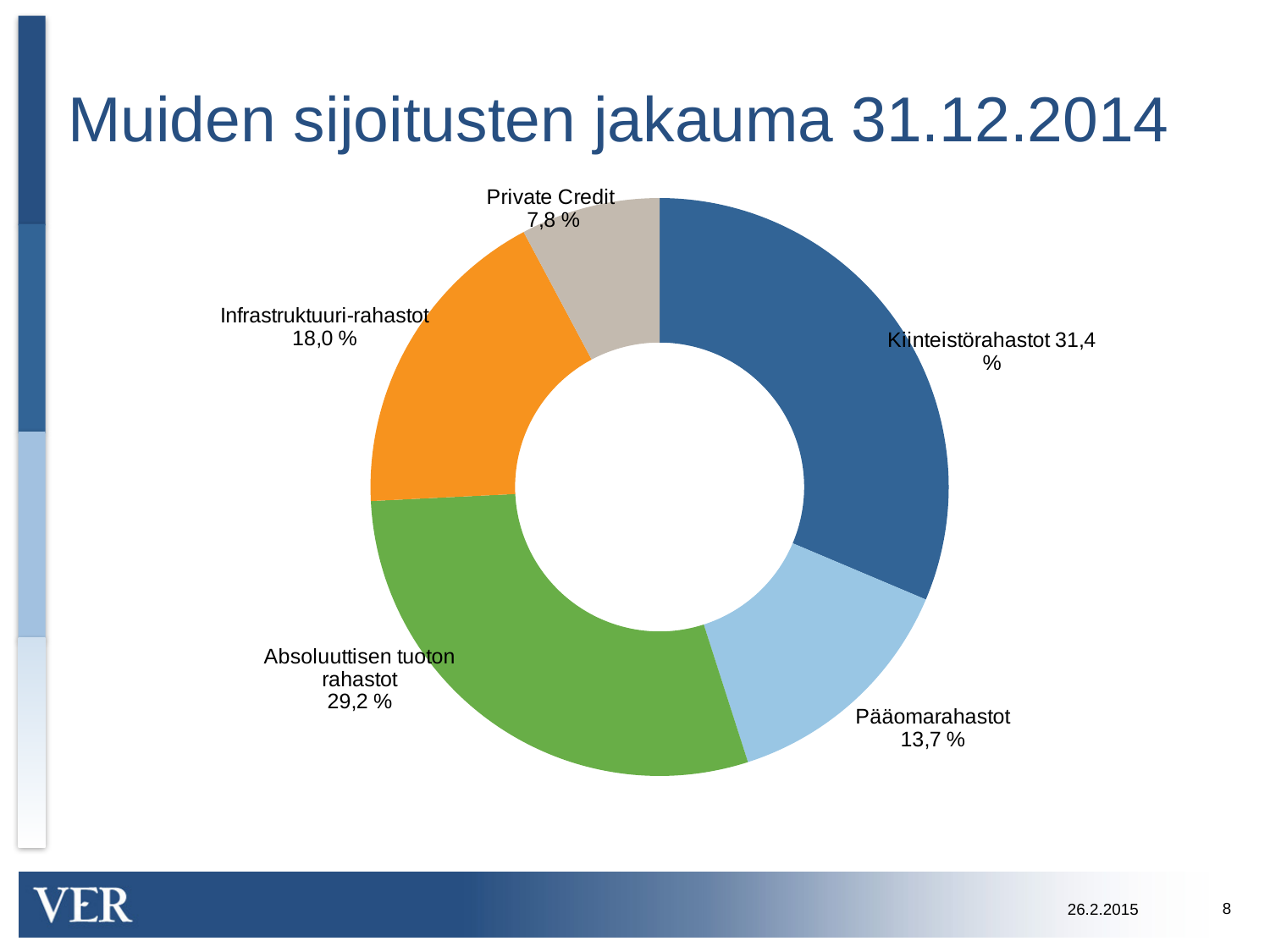
What share does Kiinteistörahastot have in the chart? 31,4 % How many categories are shown in the chart? 5 Which category has the smallest share? Private Credit Which is larger, the share of Absoluuttisen tuoton rahastot or Infrastruktuuri-rahastot? Absoluuttisen tuoton rahastot Which category has the largest share? Kiinteistörahastot What share does Absoluuttisen tuoton rahastot have? 29,2 % What is the value shown for Infrastruktuuri-rahastot? 18,0 % What is the value shown for Private Credit? 7,8 % What is the value shown for Pääomarahastot? 13,7 % What is the difference between the shares of Infrastruktuuri-rahastot and Pääomarahastot? 4,3 % What is the title of the slide? Muiden sijoitusten jakauma 31.12.2014 What kind of chart is shown on the slide? Pie chart (doughnut)